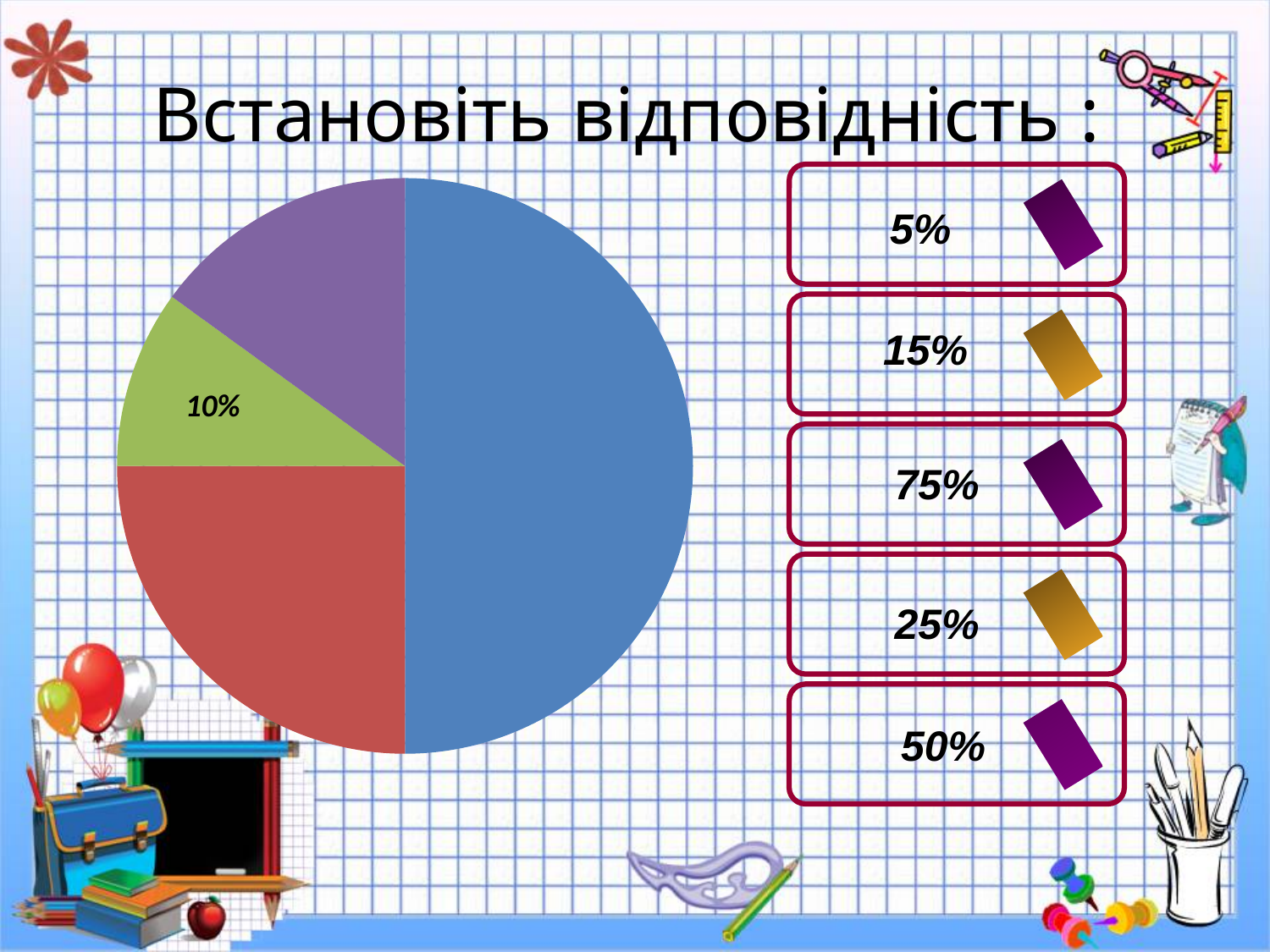
How many slices of the pie chart have a printed data label? 1 Which slice of the pie chart is the smallest? the green slice Which is larger in the pie chart, the blue slice or the red slice? the blue slice Which is larger in the pie chart, the red slice or the purple slice? the red slice Which slice of the pie chart is the largest? the blue slice Which is larger in the pie chart, the green slice or the purple slice? the purple slice What value is printed on the green slice of the pie chart? 10% What share of the pie does the green slice represent? 10% What is the title of the slide containing the pie chart? Встановіть відповідність : How many slices does the pie chart have? 4 What kind of chart is shown on the slide? pie chart